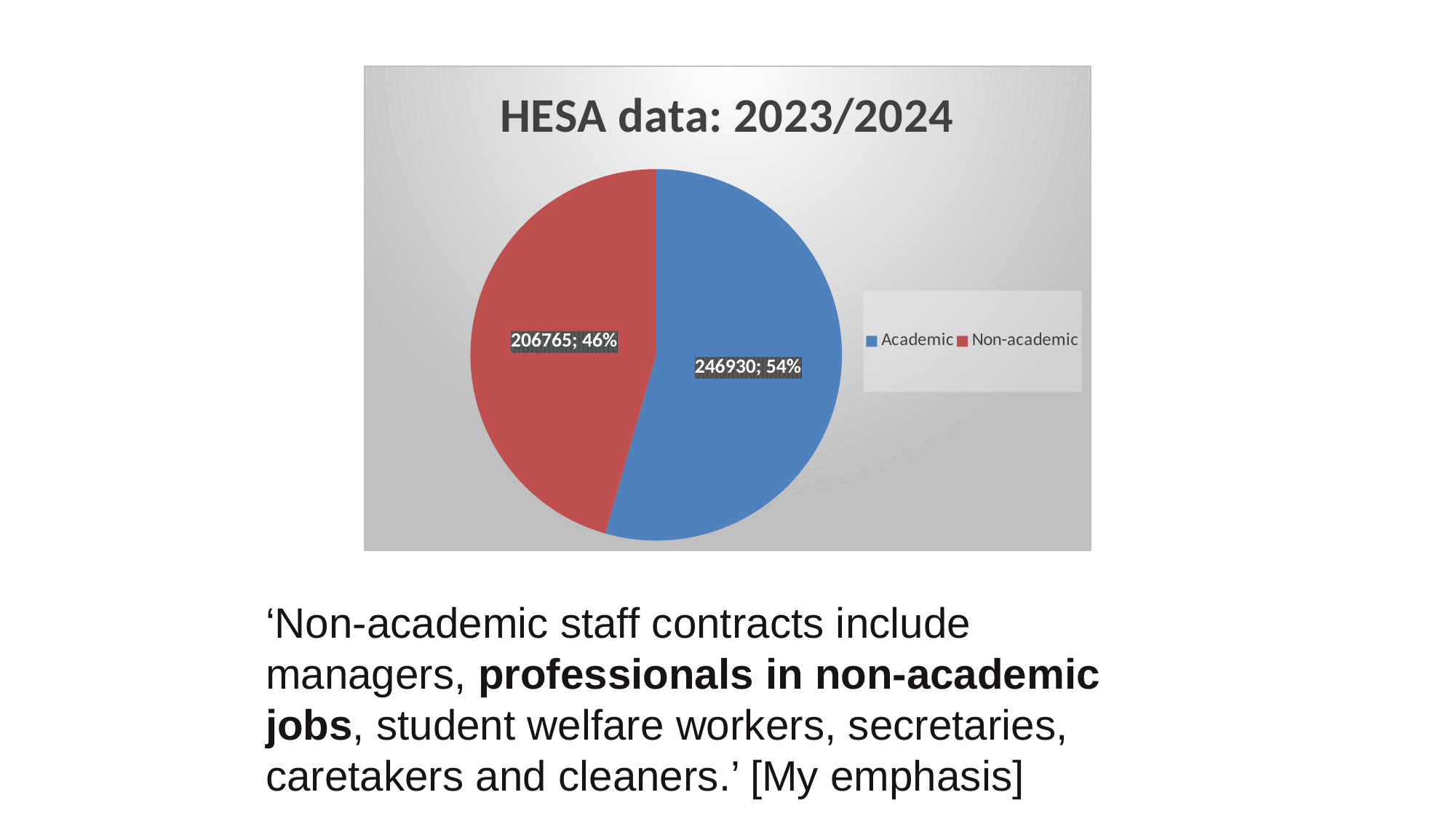
Which is larger, Academic or Non-academic? Academic How many categories are shown in the pie chart? 2 What is the difference between the Academic and Non-academic values? 40165 What colour is the Non-academic slice? Red What kind of chart is shown on the slide? Pie chart What share of the pie does the Academic slice represent? 54% Which category has the smallest slice? Non-academic What is the value for Academic? 246930 Which category has the largest slice? Academic What share of the pie does the Non-academic slice represent? 46% What is the value for Non-academic? 206765 What is the title of the chart? HESA data: 2023/2024